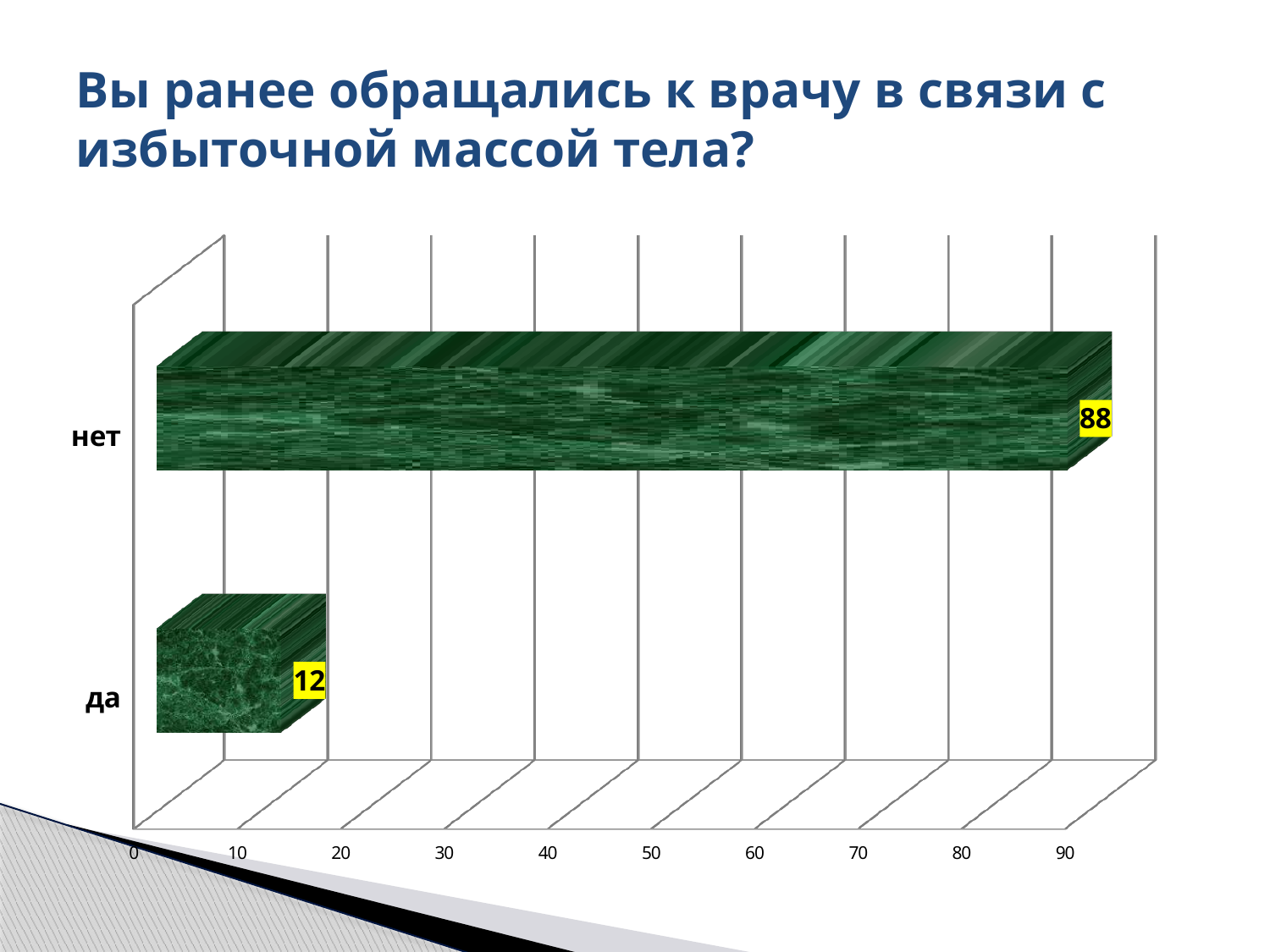
What kind of chart is shown on the slide? bar chart Is the value for "нет" greater or less than 50? greater How many categories are shown on the chart? 2 Which is larger, the value for "да" or the value for "нет"? нет Is the value for "да" greater or less than 20? less Which category has the lowest value? да What is the total of the two values shown on the chart? 100 What is the value for "нет"? 88 What is the value for "да"? 12 What is the difference between the values for "нет" and "да"? 76 Which category has the highest value? нет What is the highest tick value shown on the horizontal axis? 90